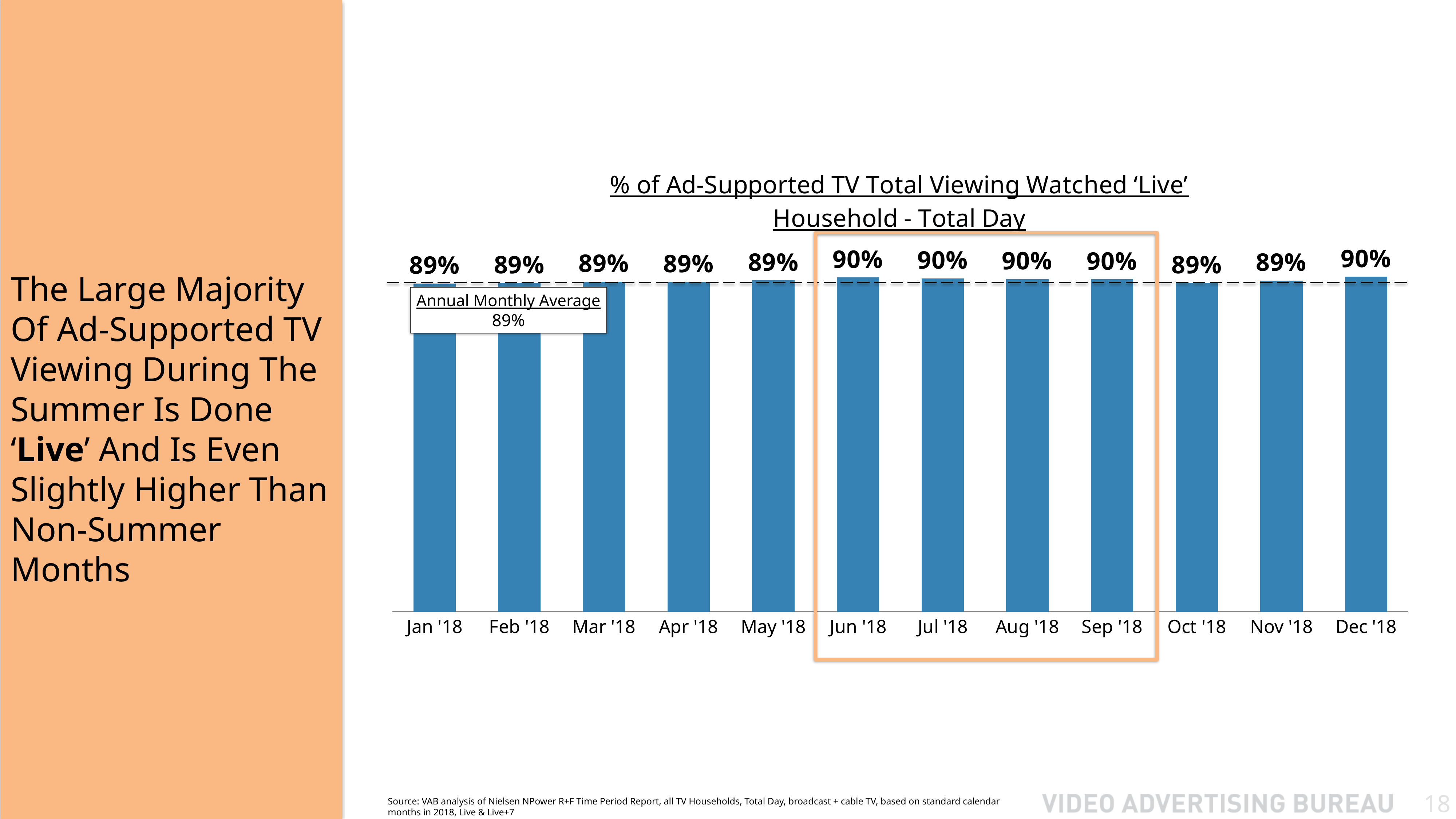
What is the value for Jan '18? 89% What is the difference between the value for Aug '18 and the value for Nov '18? 1% What kind of chart is shown? Bar chart Which is larger, the value for Jun '18 or the value for Feb '18? Jun '18 Is the value for Sep '18 greater or less than the Annual Monthly Average of 89%? greater What is the title of the chart? % of Ad-Supported TV Total Viewing Watched 'Live' Household - Total Day How many months are shown on the x axis? 12 What is the Annual Monthly Average shown by the dashed line? 89% What is the value for Jul '18? 90% What is the value for Dec '18? 90% What is the value for Oct '18? 89% How many months have a value of 90%? 5